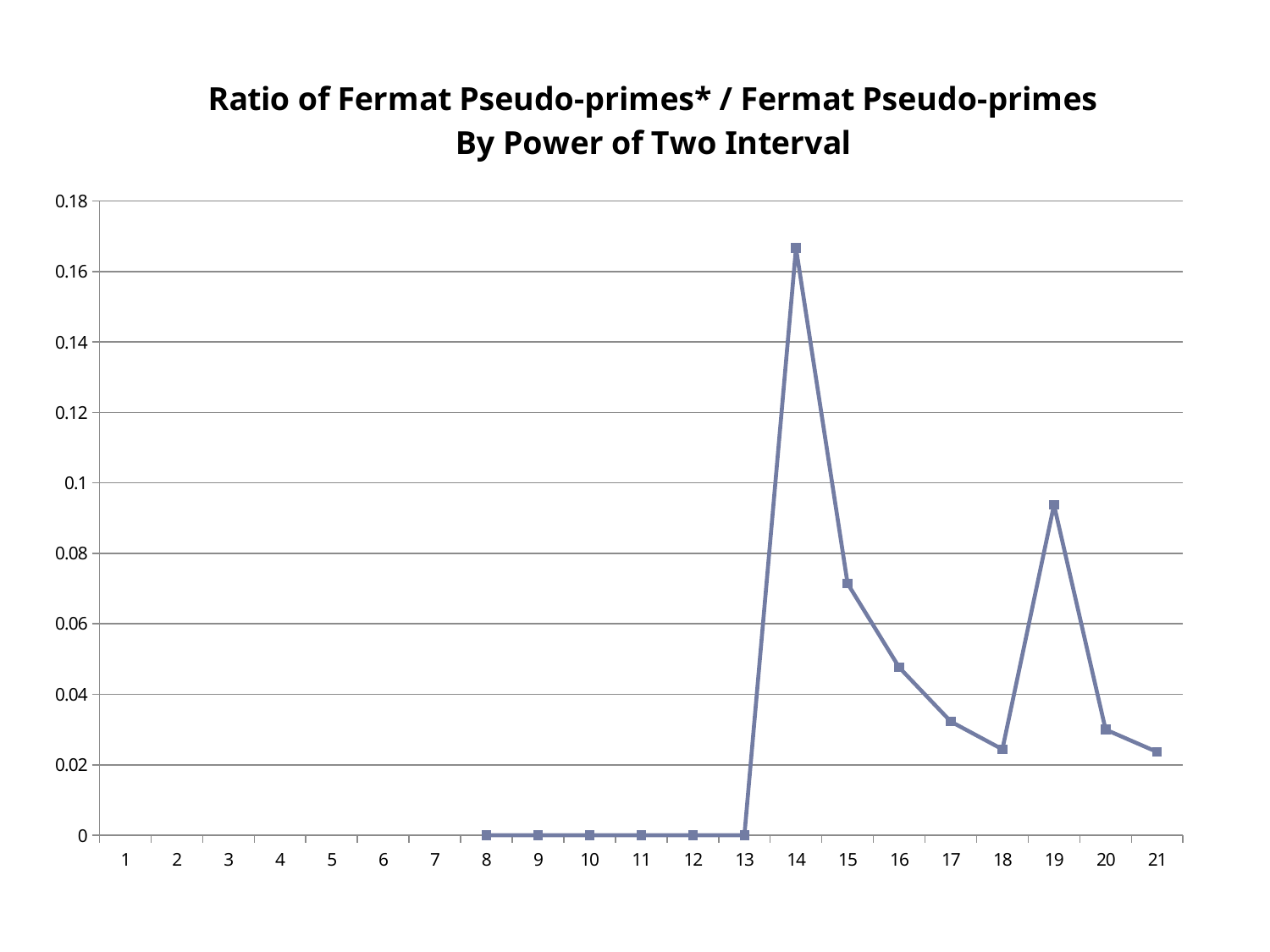
Is the value at x = 18 greater or less than 0.04? less Is the value at x = 19 greater or less than 0.08? greater Is the value at x = 14 greater or less than 0.14? greater What is the value plotted at x = 13? 0 How many categories are labelled on the x axis? 21 What is the value plotted at x = 10? 0 Which has the larger value, x = 14 or x = 19? 14 What is the title of the chart? Ratio of Fermat Pseudo-primes* / Fermat Pseudo-primes By Power of Two Interval What kind of chart is shown on the slide? line chart Do the values rise or fall from x = 14 to x = 18? fall Which x-axis category has the highest value? 14